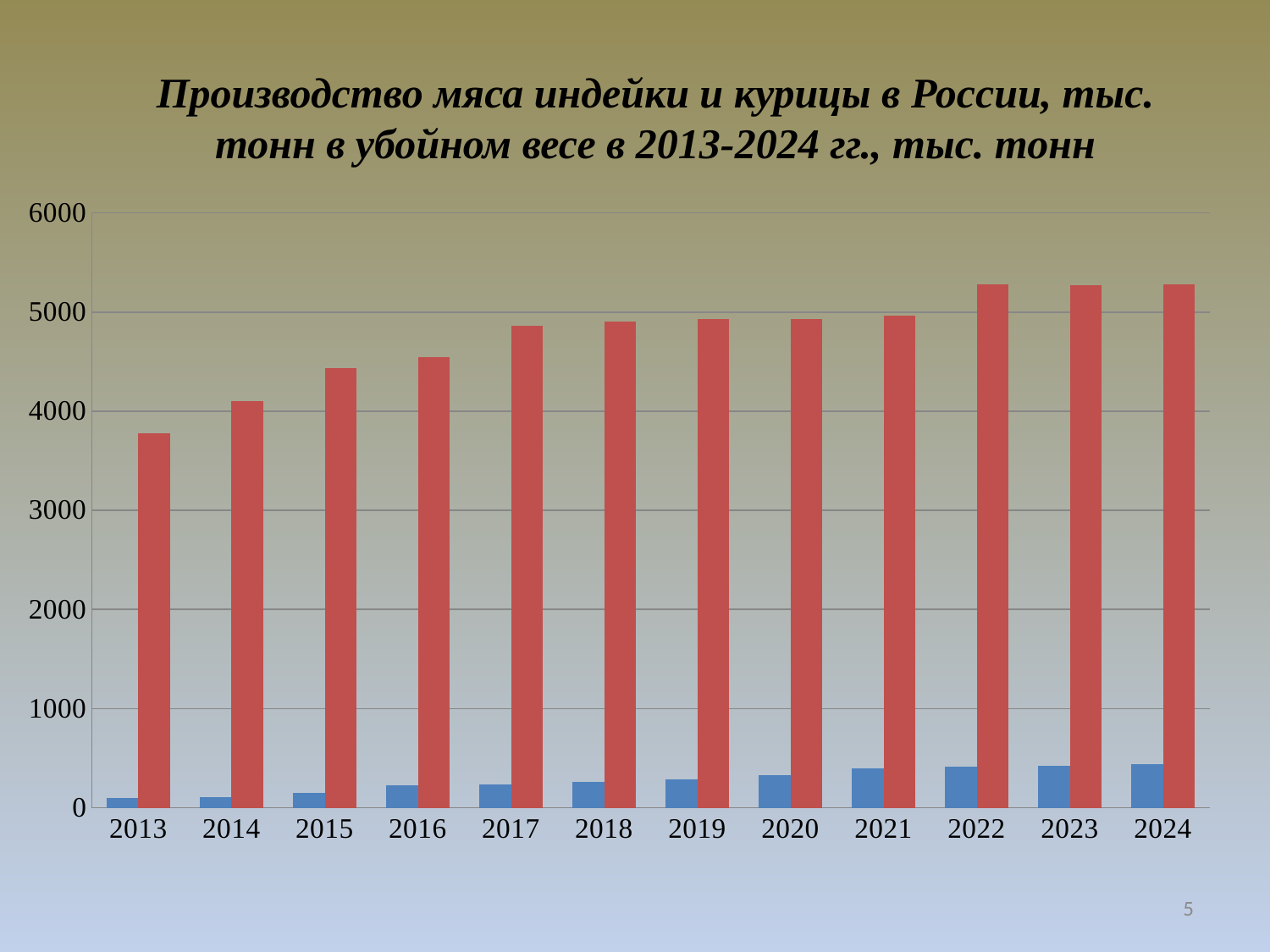
In which year is the red bar the lowest? 2013 Which is larger in 2020, the red bar or the blue bar? the red bar How many years are shown on the x axis of the chart? 12 Do the red bars rise or fall from 2013 to 2024? rise What is the title of the chart? Производство мяса индейки и курицы в России, тыс. тонн в убойном весе в 2013-2024 гг., тыс. тонн Which is larger, the blue bar for 2013 or the blue bar for 2024? the blue bar for 2024 Is the value of the red bar for 2016 greater or less than 5000? less What kind of chart is shown on the slide? bar chart How many data series (bar colours) are plotted in the chart? 2 Is the value of the red bar for 2024 greater or less than 5000? greater Is the value of the red bar for 2013 greater or less than 4000? less